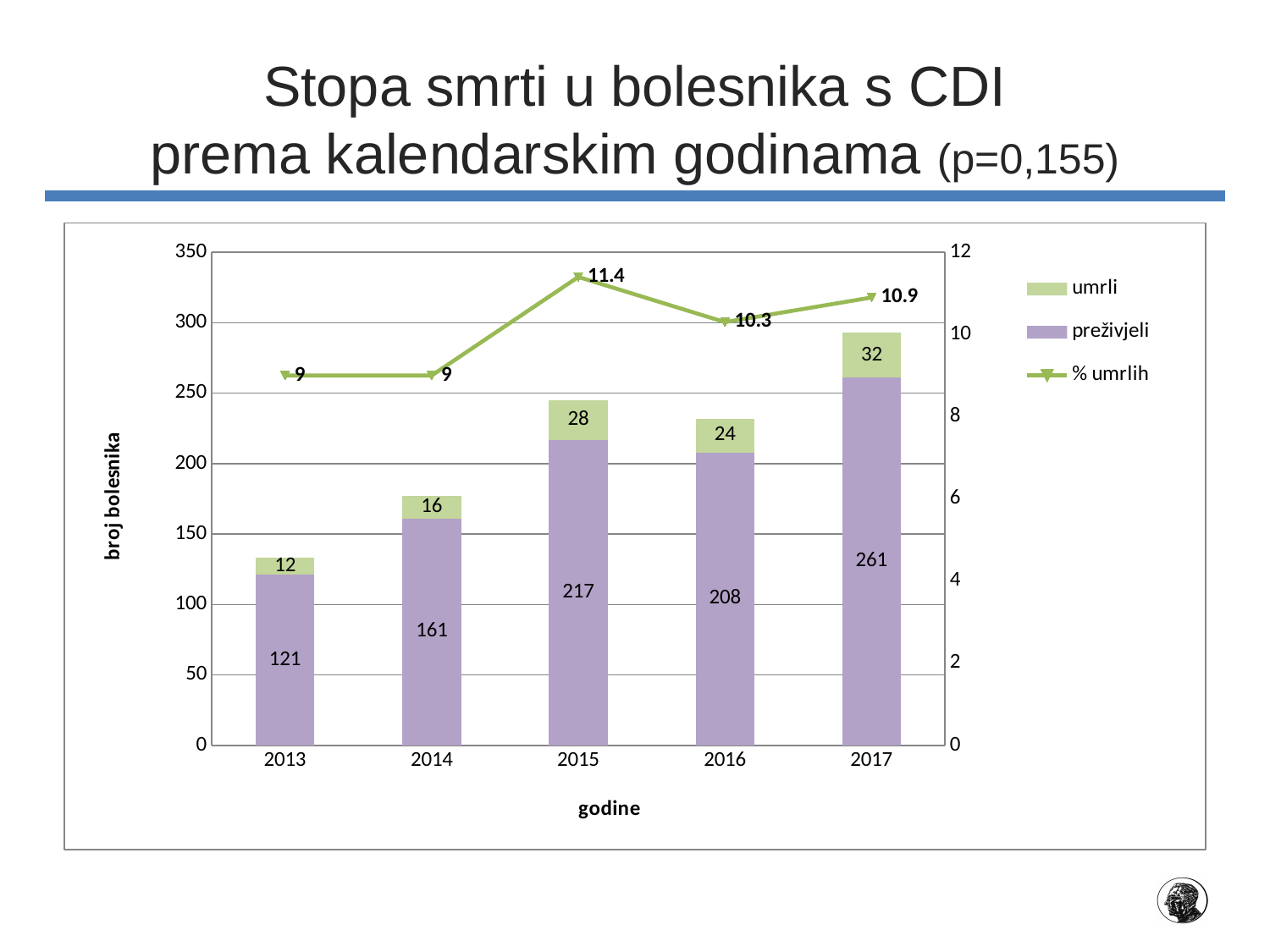
Does the % umrlih line rise or fall from 2014 to 2015? rise What is the % umrlih value for 2015? 11.4 What is the total number of patients (umrli plus preživjeli) in 2016? 232 Which year has the lowest number of survivors (preživjeli)? 2013 What is the difference between the number of survivors in 2017 and in 2013? 140 How many series does the legend list? 3 Which year has the highest number of deaths (umrli)? 2017 How many patients died (umrli) in 2017? 32 How many years are shown on the x axis? 5 What is the label of the y axis on the left? broj bolesnika Which year has more deaths (umrli), 2014 or 2016? 2016 How many patients survived (preživjeli) in 2015? 217